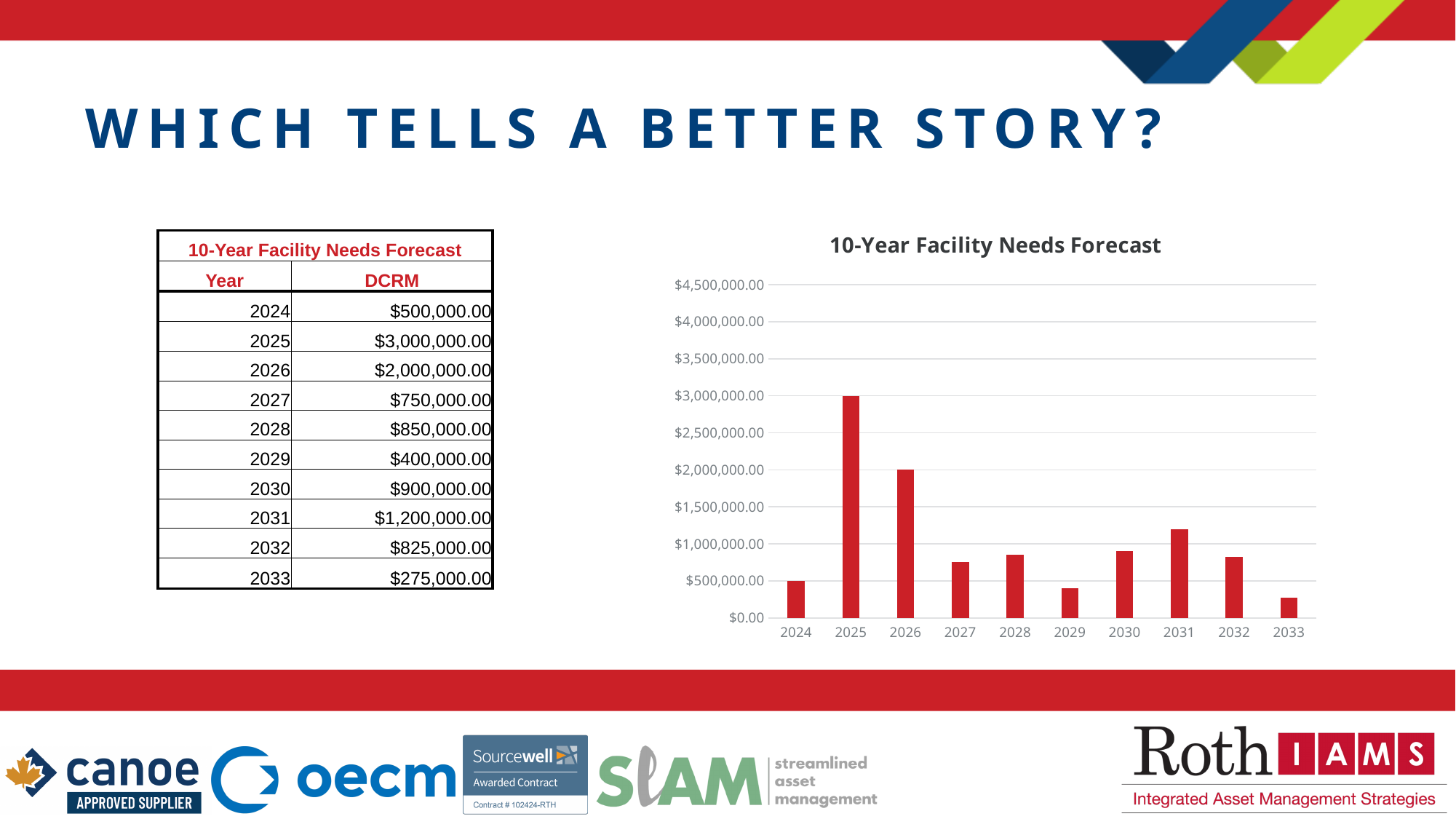
What is the title of the chart? 10-Year Facility Needs Forecast Which year has the lowest bar in the chart? 2033 What is the value plotted for 2024 in the chart? $500,000.00 What is the value plotted for 2026 in the chart? $2,000,000.00 In the chart, which year has the larger value, 2027 or 2030? 2030 What is the value plotted for 2025 in the chart? $3,000,000.00 What type of chart is shown on the slide? bar chart Is the value for 2029 in the chart greater or less than $500,000.00? less What is the difference between the values for 2025 and 2026 in the chart? $1,000,000.00 Is the value for 2031 in the chart greater or less than $1,000,000.00? greater Which year has the highest bar in the chart? 2025 How many years are plotted on the x axis of the chart? 10